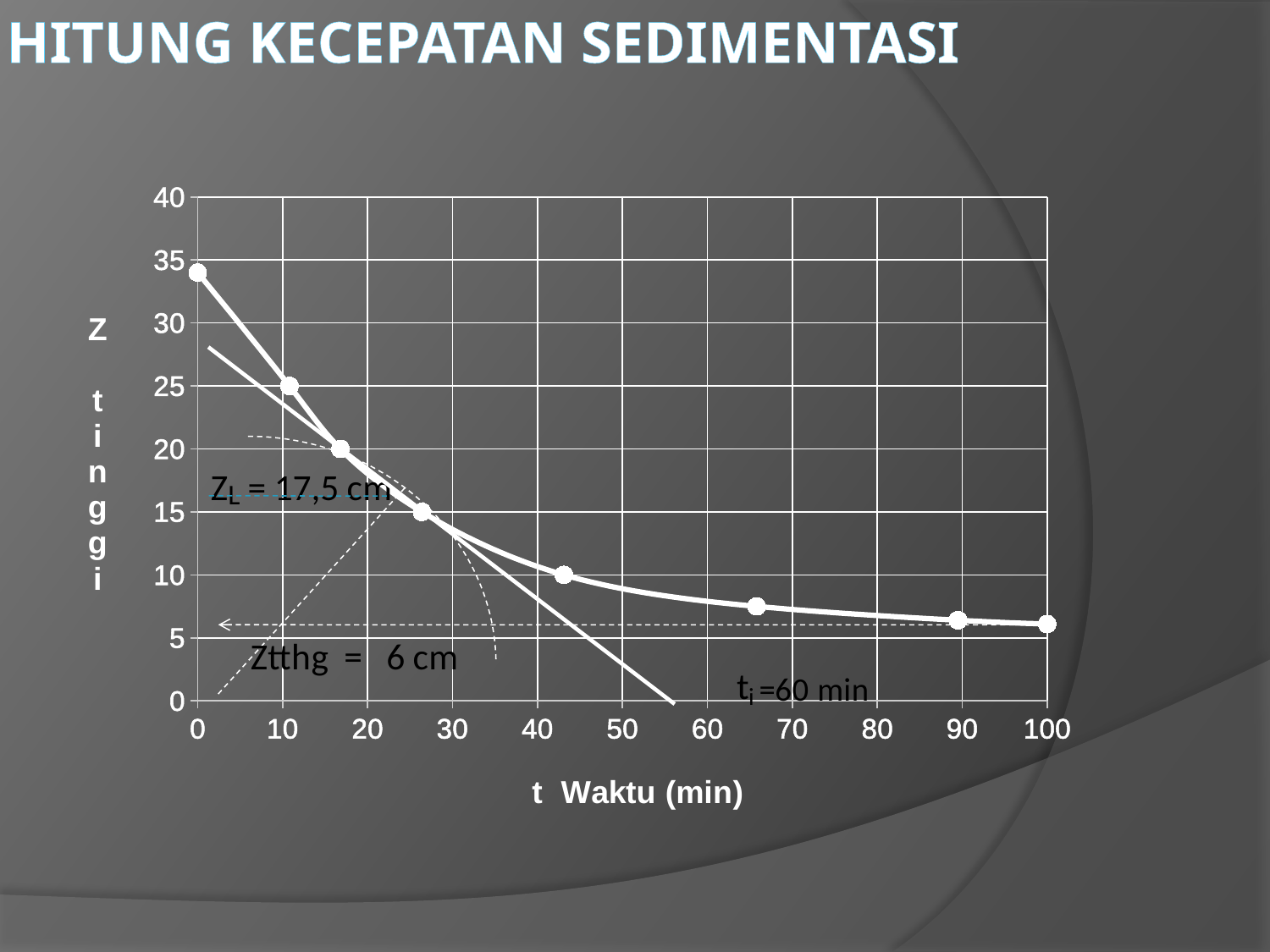
Which plotted point has the highest Z value, the first one (t = 0) or the last one (t = 100)? the first one (t = 0) What value of ti is annotated on the chart? 60 min Is the value of Z at t = 0 greater or less than 30? greater What kind of chart is shown on the slide? line chart What is the title of the slide chart? HITUNG KECEPATAN SEDIMENTASI What is the label of the x axis? t Waktu (min) Is the value of Z at t = 100 greater or less than 10? less Do the plotted values rise or fall as time increases along the x axis? fall How many data points are plotted on the curve? 8 Is the value of Z at the last plotted point greater or less than 5? greater What value of ZL is annotated on the chart? 17,5 cm What value of Zthg is annotated on the chart? 6 cm